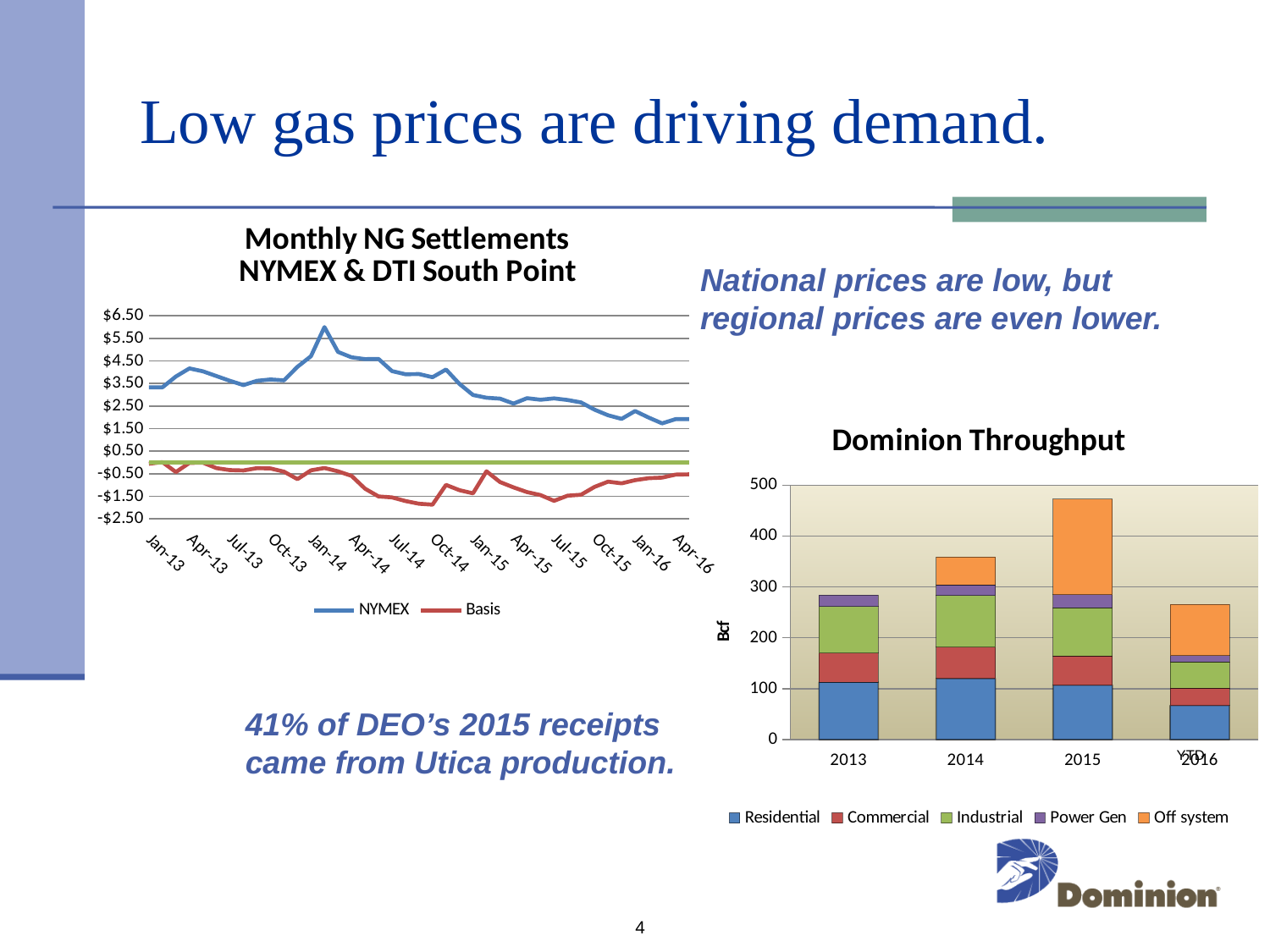
What kind of chart is the "Dominion Throughput" chart? stacked bar chart How many series does the legend of the "Dominion Throughput" chart list? 5 In the "Dominion Throughput" chart, which year has the tallest total bar? 2015 What kind of chart is the "Monthly NG Settlements NYMEX & DTI South Point" chart? line chart How many categories are shown on the x axis of the "Dominion Throughput" chart? 4 What is the y-axis label of the "Dominion Throughput" chart? Bcf In the "Dominion Throughput" chart, is the total bar for 2015 greater or less than 400? greater In the "Dominion Throughput" chart, which category has the shortest total bar? YTD 2016 How many series does the legend of the "Monthly NG Settlements NYMEX & DTI South Point" chart list? 2 In the "Monthly NG Settlements NYMEX & DTI South Point" chart, is the NYMEX value at Jan-14 greater or less than $4.50? greater In the "Monthly NG Settlements NYMEX & DTI South Point" chart, is the NYMEX value at Apr-16 greater or less than $2.50? less In the "Monthly NG Settlements NYMEX & DTI South Point" chart, does the NYMEX series overall rise or fall from Jan-14 to Apr-16? fall